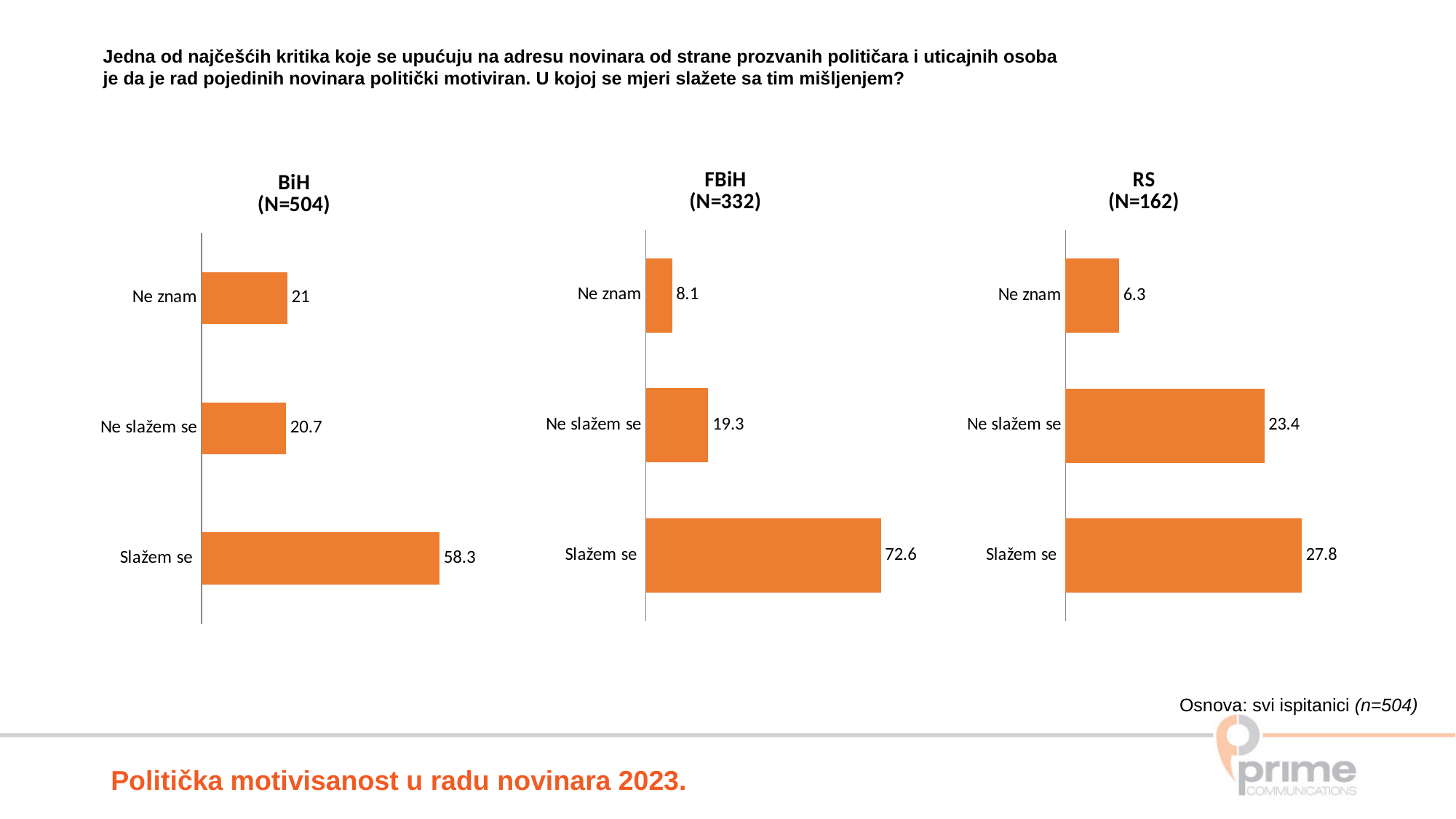
In the FBiH (N=332) chart, which is larger: "Ne slažem se" or "Ne znam"? Ne slažem se In the RS (N=162) chart, what is the value for "Ne slažem se"? 23.4 How many categories are shown in the BiH (N=504) chart? 3 In the BiH (N=504) chart, what is the value for "Slažem se"? 58.3 In the FBiH (N=332) chart, what is the value for "Ne znam"? 8.1 In the RS (N=162) chart, which category has the lowest value? Ne znam In the FBiH (N=332) chart, which category has the highest value? Slažem se In the BiH (N=504) chart, what is the difference between "Slažem se" and "Ne slažem se"? 37.6 What type of chart is the RS (N=162) chart? Bar chart Which chart has the higher value for "Slažem se": FBiH (N=332) or RS (N=162)? FBiH (N=332) How many charts are shown on the slide? 3 In the RS (N=162) chart, what is the difference between "Slažem se" and "Ne slažem se"? 4.4